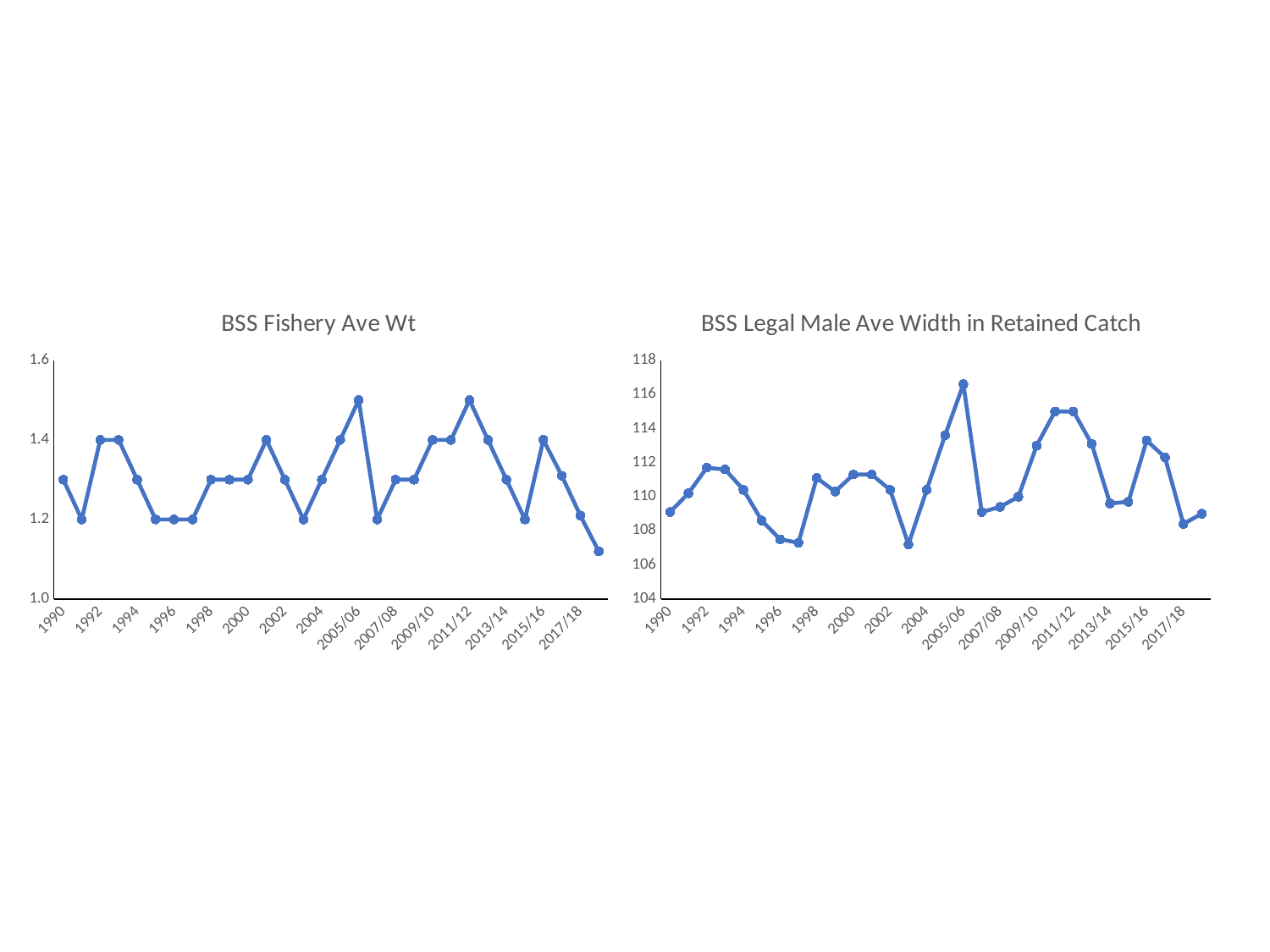
In the 'BSS Fishery Ave Wt' chart, do the values rise or fall from 1992 to 1996? fall In the 'BSS Legal Male Ave Width in Retained Catch' chart, which is larger, the value for 2011/12 or the value for 2013/14? 2011/12 In the 'BSS Fishery Ave Wt' chart, is the value for 1990 greater or less than 1.2? greater In the 'BSS Legal Male Ave Width in Retained Catch' chart, is the value for 2011/12 greater or less than 114? greater What kind of chart is the 'BSS Fishery Ave Wt' chart? line chart What is the title of the chart on the right of the slide? BSS Legal Male Ave Width in Retained Catch In the 'BSS Legal Male Ave Width in Retained Catch' chart, do the values rise or fall from 2007/08 to 2011/12? rise In the 'BSS Legal Male Ave Width in Retained Catch' chart, is the value for 2017/18 greater or less than 110? less In the 'BSS Fishery Ave Wt' chart, what is the value for 1992? 1.4 In the 'BSS Fishery Ave Wt' chart, what is the value for 1996? 1.2 In the 'BSS Fishery Ave Wt' chart, which is larger, the value for 1992 or the value for 1996? 1992